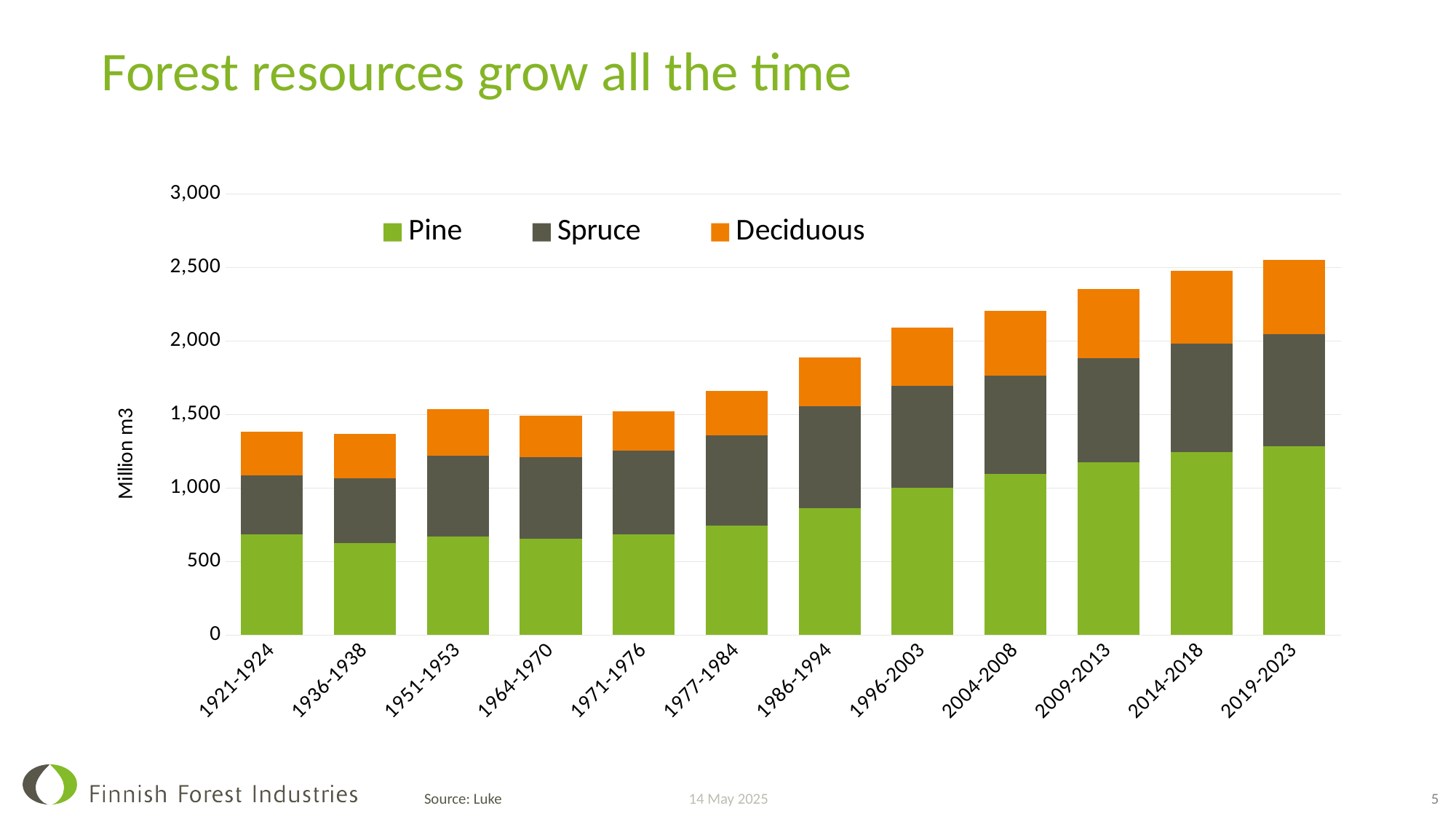
Is the Pine value for 1936-1938 greater or less than 1,000? less What is the label on the y axis? Million m3 How many time periods are shown on the x axis? 12 Which period has the highest total stacked bar? 2019-2023 Which has the larger total stacked bar, 1921-1924 or 2019-2023? 2019-2023 Is the total stacked bar for 2009-2013 greater or less than 2,000? greater Is the total stacked bar for 1921-1924 greater or less than 1,500? less How many series does the legend list? 3 Do the total stacked bars generally rise or fall from 1921-1924 to 2019-2023? rise What kind of chart is shown on the slide? Stacked bar chart